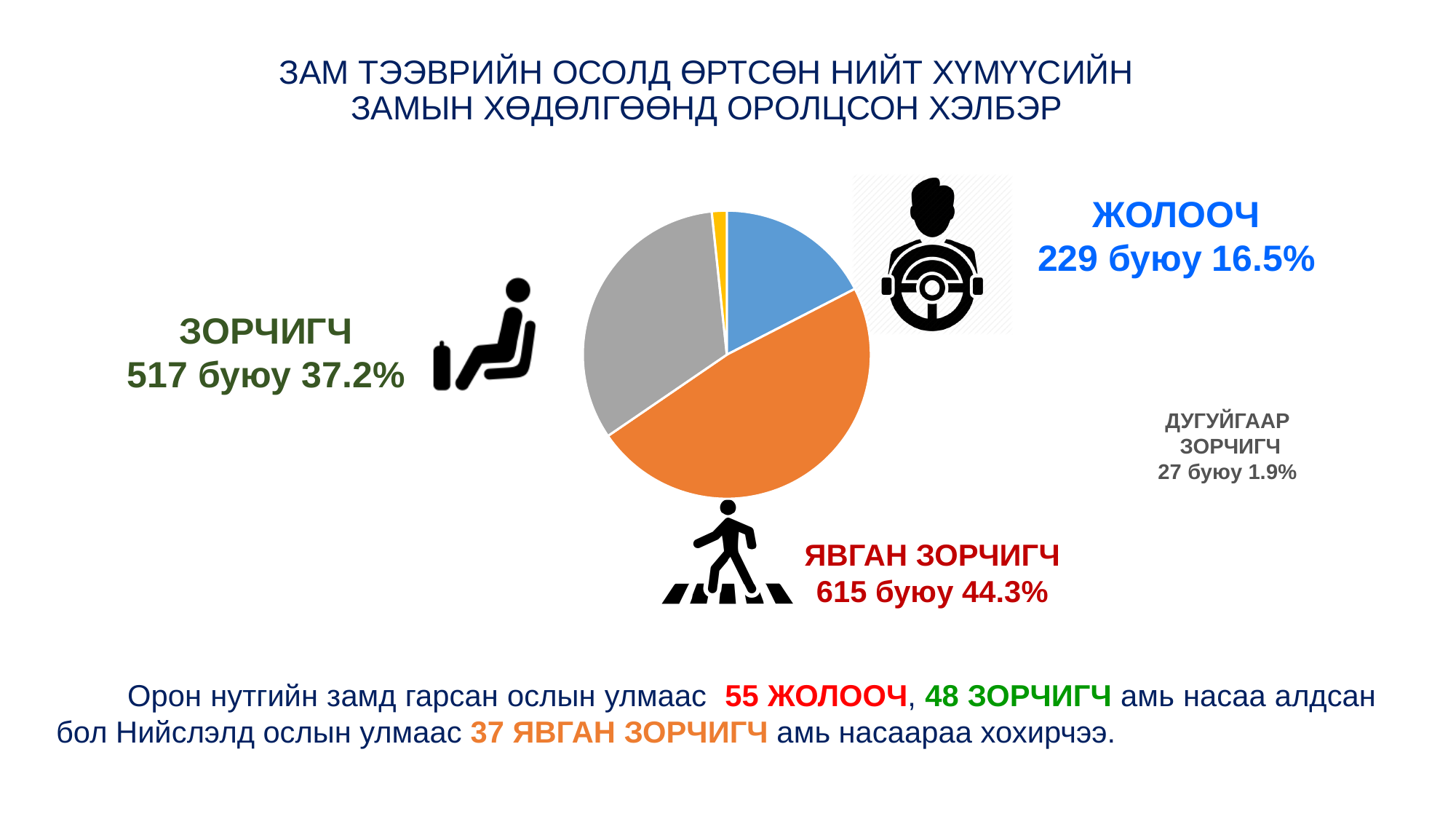
How many categories does the pie chart show? 4 Which is larger, the value for ЖОЛООЧ or the value for ЗОРЧИГЧ? ЗОРЧИГЧ What is the value for ЗОРЧИГЧ? 517 Which category is shown by the orange slice of the pie? ЯВГАН ЗОРЧИГЧ Which category has the largest share of the pie? ЯВГАН ЗОРЧИГЧ Which category has the smallest share of the pie? ДУГУЙГААР ЗОРЧИГЧ What is the difference between the values for ЯВГАН ЗОРЧИГЧ and ЗОРЧИГЧ? 98 What is the value for ЖОЛООЧ? 229 What share of the pie does ЗОРЧИГЧ represent? 37.2% What is the value for ЯВГАН ЗОРЧИГЧ? 615 What is the value for ДУГУЙГААР ЗОРЧИГЧ? 27 What kind of chart is shown on the slide? Pie chart